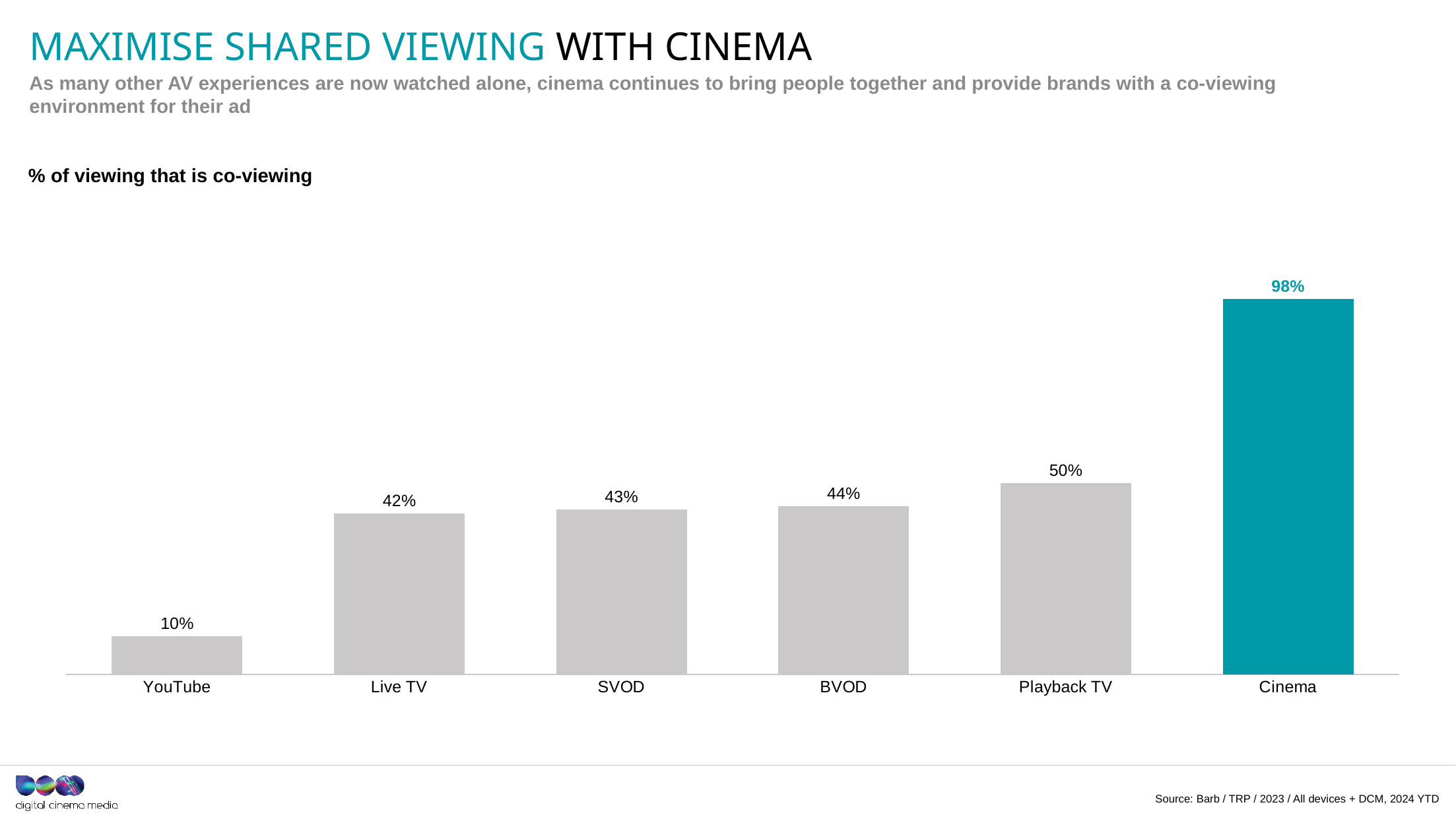
Which category has the lowest value? YouTube What is the value for Playback TV? 50% What is the value for YouTube? 10% What kind of chart is shown on the slide? Bar chart What is the difference between the values for Cinema and Playback TV? 48% How many categories are shown on the chart? 6 What is the difference between the values for Live TV and YouTube? 32% What is the value for Cinema? 98% Which is larger, the value for Cinema or the value for BVOD? Cinema Which category has the highest value? Cinema What is the value for SVOD? 43% What is the title of the chart? % of viewing that is co-viewing